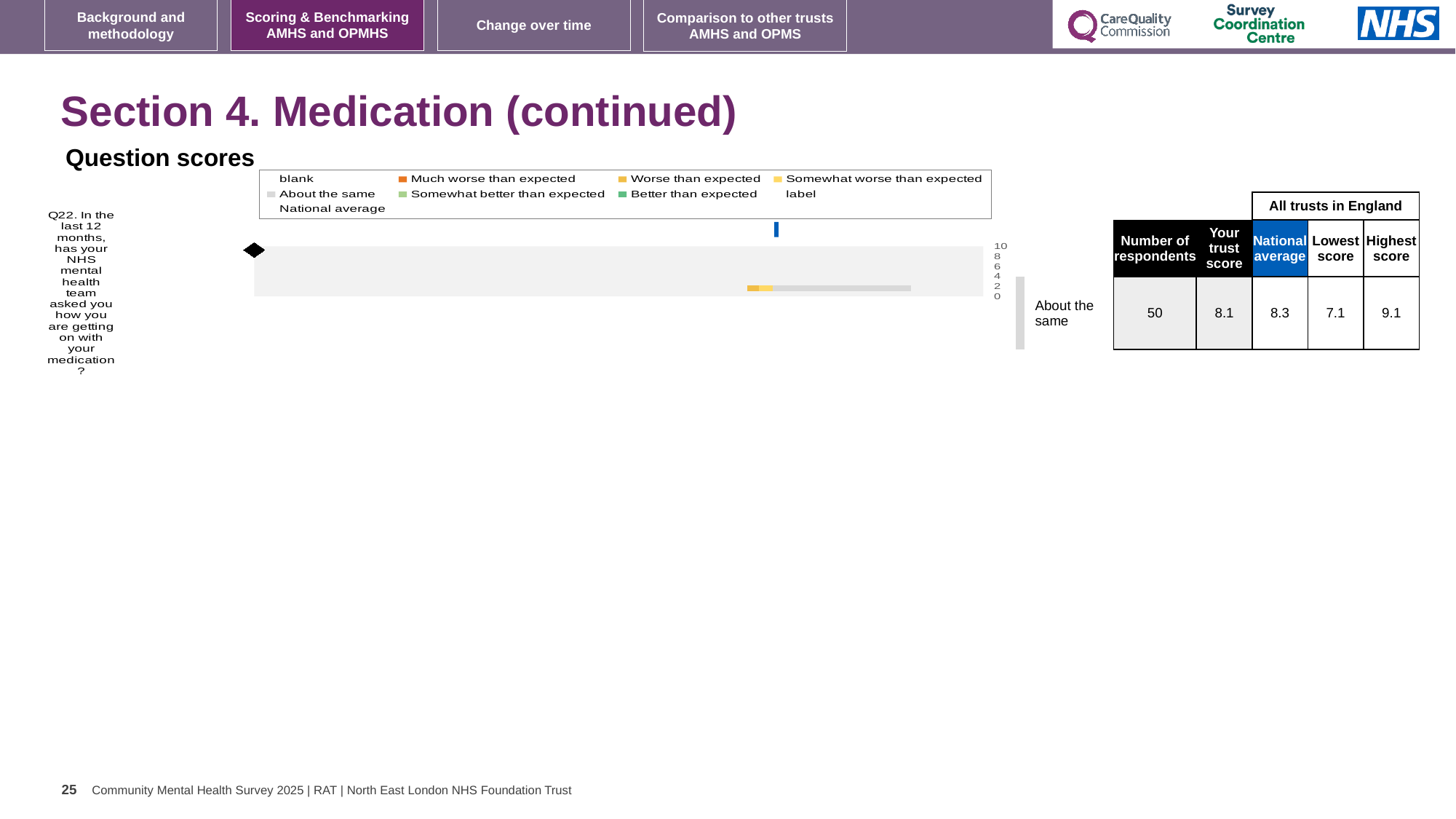
What is the national average score for Q22? 8.3 Which is larger for Q22, the trust's score or the national average? national average What kind of chart is shown under 'Question scores'? bar chart Which question is plotted in the Question scores chart? Q22. In the last 12 months, has your NHS mental health team asked you how you are getting on with your medication? How many respondents answered Q22? 50 What is the highest score among all trusts in England for Q22? 9.1 What is the trust's score for Q22? 8.1 Which benchmark category is Q22 assigned to in the Question scores chart? About the same How many questions are plotted in the Question scores chart? 1 What is the difference between the highest and lowest scores for Q22 across all trusts in England? 2.0 What is the difference between the national average and the trust's score for Q22? 0.2 What is the lowest score among all trusts in England for Q22? 7.1